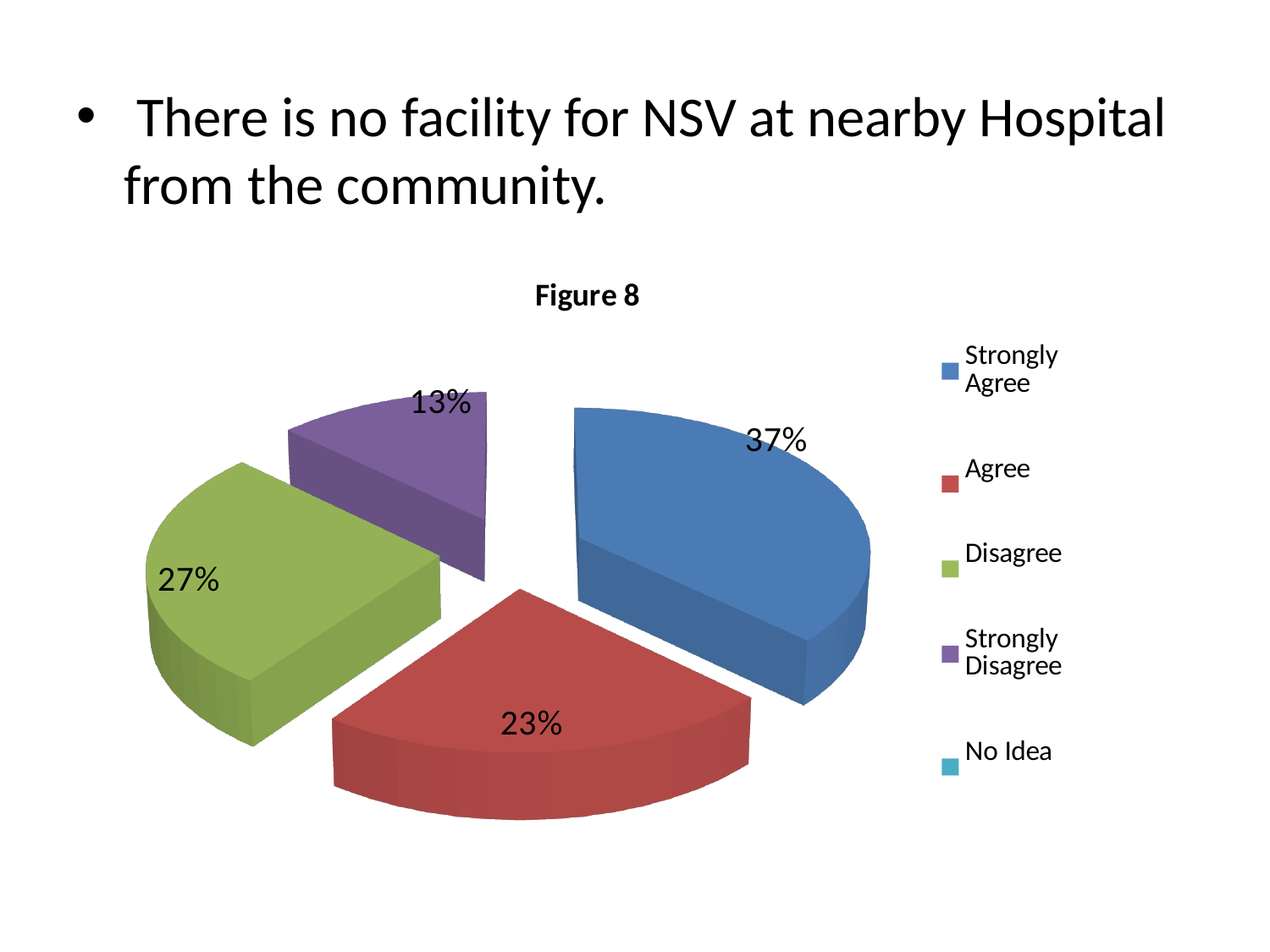
What percentage of the pie is labelled for Strongly Disagree? 13% What kind of chart is shown on the slide? pie chart Which slice is larger, Agree or Disagree? Disagree What percentage of the pie is labelled for Strongly Agree? 37% What percentage of the pie is labelled for Agree? 23% How many entries does the legend list? 5 What is the difference in percentage points between the Strongly Agree and Strongly Disagree slices? 24 What colour is the Strongly Agree slice? blue What percentage of the pie is labelled for Disagree? 27% What is the chart's title? Figure 8 Which labelled slice is the smallest in the pie? Strongly Disagree Which category has the largest slice of the pie? Strongly Agree